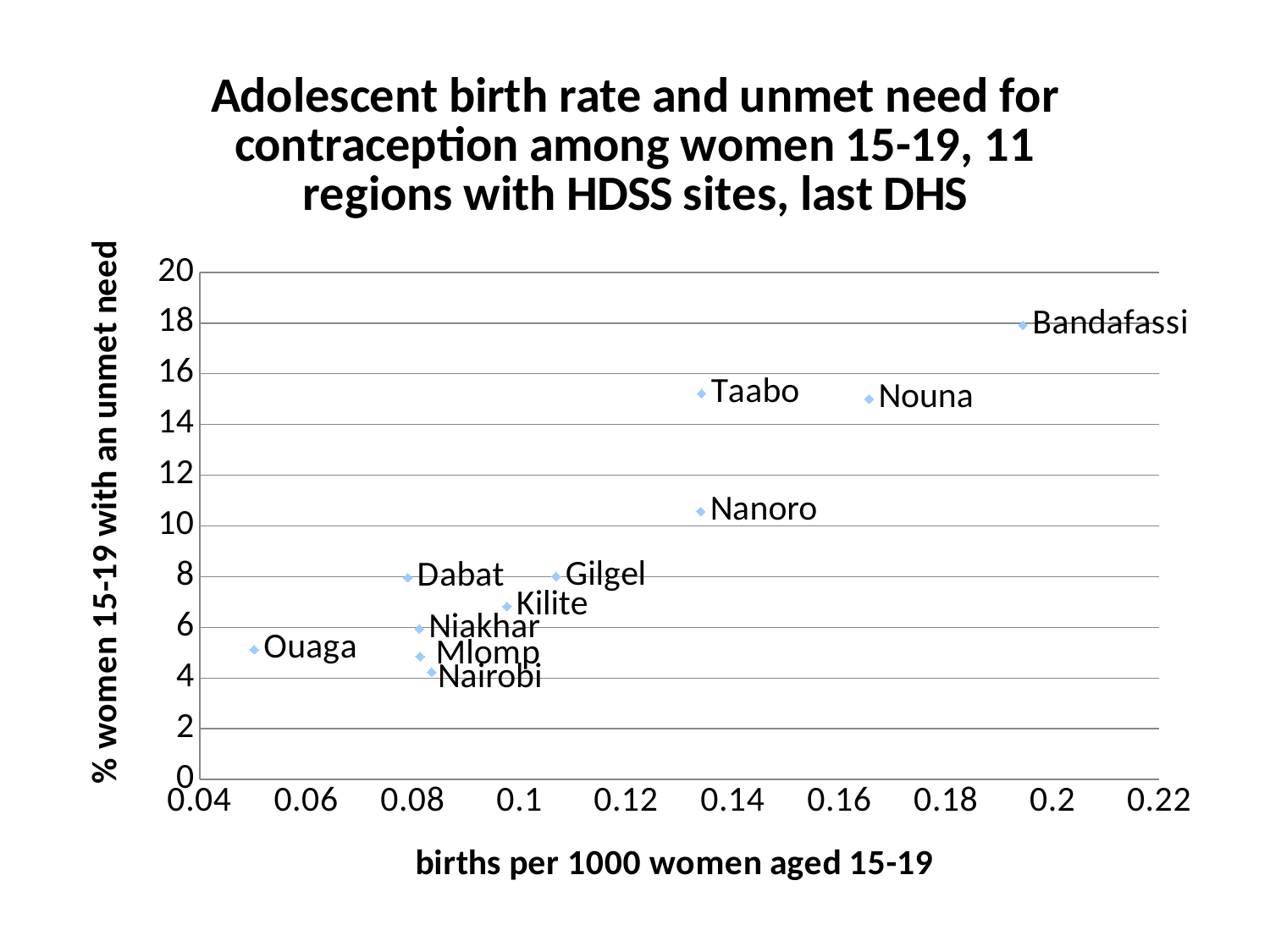
Which region has the highest percentage of women 15-19 with an unmet need? Bandafassi Which region has the lowest adolescent birth rate (births per 1000 women aged 15-19)? Ouaga What kind of chart is shown on the slide? scatter chart Which region has the highest adolescent birth rate (births per 1000 women aged 15-19)? Bandafassi Is the birth rate value for Ouaga greater or less than 0.06? less Is the unmet need value for Nanoro greater or less than 12? less Which region has the lowest percentage of women 15-19 with an unmet need? Nairobi Is the unmet need value for Bandafassi greater or less than 16? greater Which has a higher unmet need percentage, Taabo or Nanoro? Taabo How many regions (data points) are plotted on the chart? 11 What is the label of the vertical axis? % women 15-19 with an unmet need